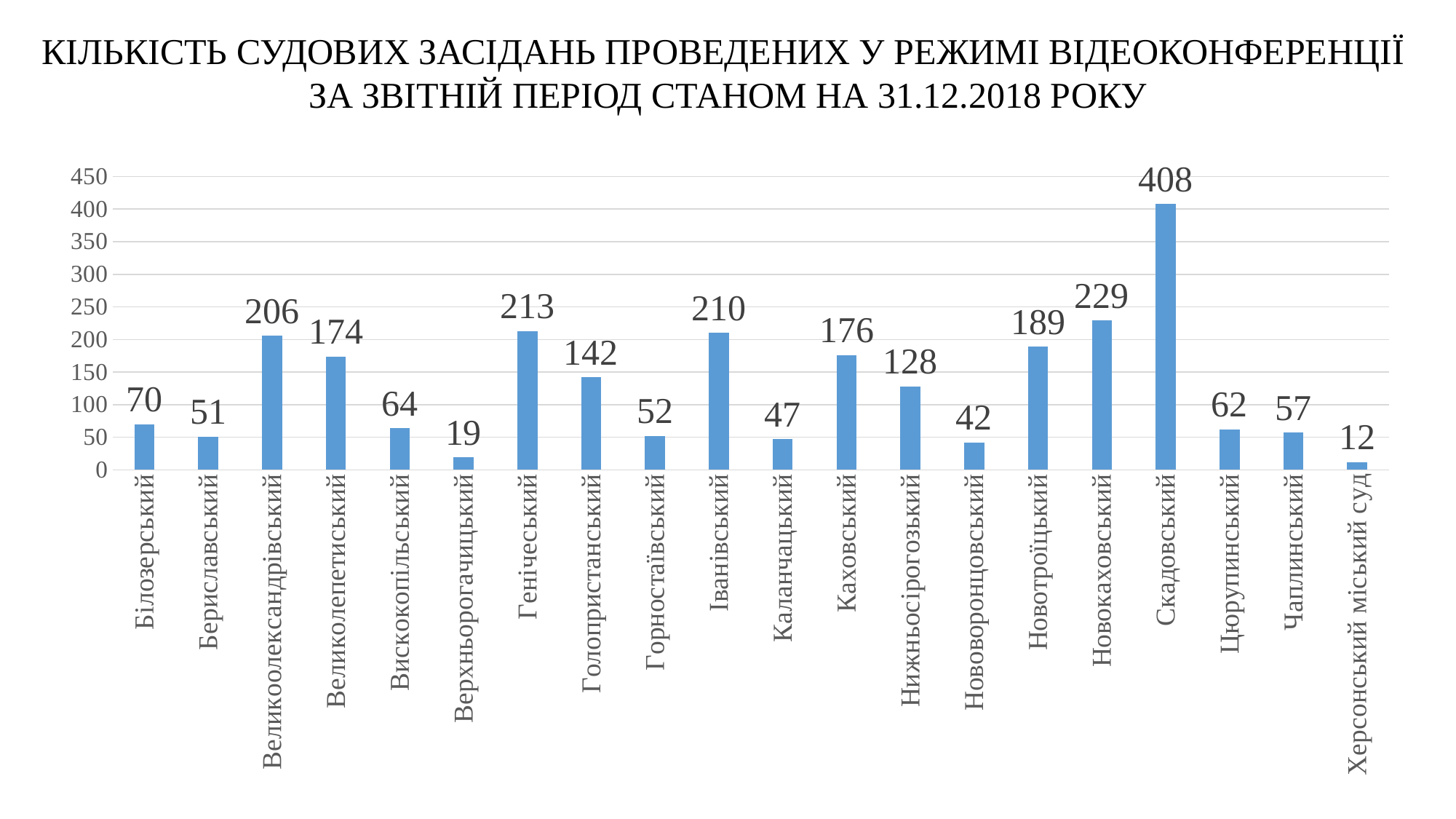
What is the difference between the values for Скадовський and Новокаховський? 179 What is the value for Верхньорогачицький? 19 Which category has the lowest value? Херсонський міський суд What is the highest tick value shown on the vertical axis? 450 What is the value for Голопристанський? 142 Is the value for Новотроїцький greater or less than 150? greater What is the value for Скадовський? 408 What is the difference between the values for Генічеський and Іванівський? 3 Which is larger, the value for Каховський or the value for Нижньосірогозький? Каховський Which category has the highest value? Скадовський How many categories are shown on the x axis? 20 What kind of chart is shown on the slide? bar chart